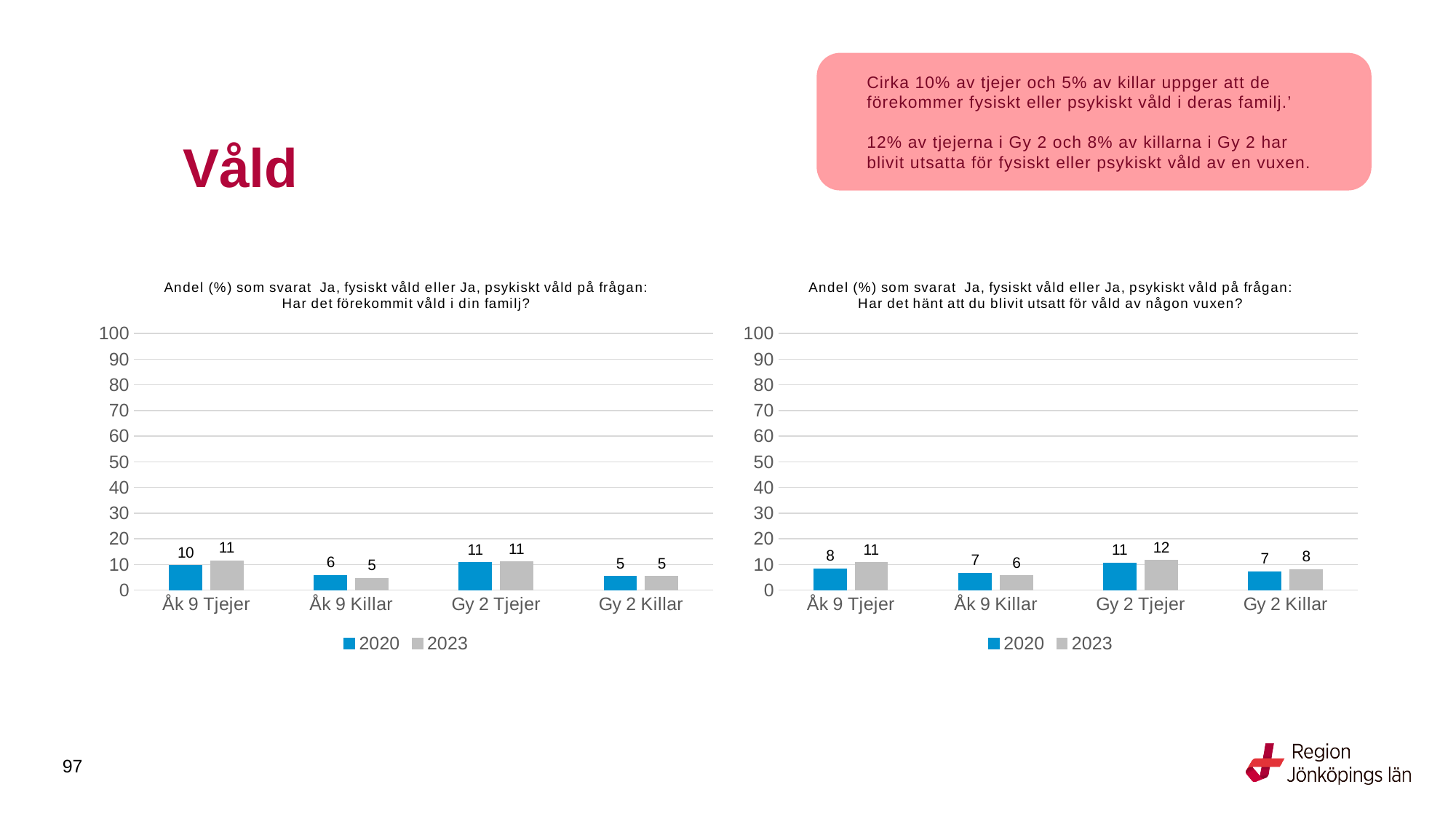
In the right chart (Har det hänt att du blivit utsatt för våld av någon vuxen?), is the value for Gy 2 Tjejer in 2023 greater or less than 20? less In the left chart (Har det förekommit våld i din familj?), which is larger for Åk 9 Killar: the 2020 value or the 2023 value? 2020 In the left chart (Har det förekommit våld i din familj?), what is the value for Åk 9 Killar in 2020? 6 In the right chart (Har det hänt att du blivit utsatt för våld av någon vuxen?), which category has the highest value in 2023? Gy 2 Tjejer How many categories are shown on the x axis of the left chart (Har det förekommit våld i din familj?)? 4 In the left chart (Har det förekommit våld i din familj?), what is the value for Åk 9 Tjejer in 2023? 11 In the right chart (Har det hänt att du blivit utsatt för våld av någon vuxen?), what is the value for Gy 2 Killar in 2023? 8 How many series does the legend of the right chart (Har det hänt att du blivit utsatt för våld av någon vuxen?) list? 2 What kind of chart is the left chart (Har det förekommit våld i din familj?)? Bar chart In the left chart (Har det förekommit våld i din familj?), which category has the lowest value in 2020? Gy 2 Killar In the right chart (Har det hänt att du blivit utsatt för våld av någon vuxen?), what is the difference between the 2023 and 2020 values for Åk 9 Tjejer? 3 In the right chart (Har det hänt att du blivit utsatt för våld av någon vuxen?), what is the value for Gy 2 Tjejer in 2020? 11